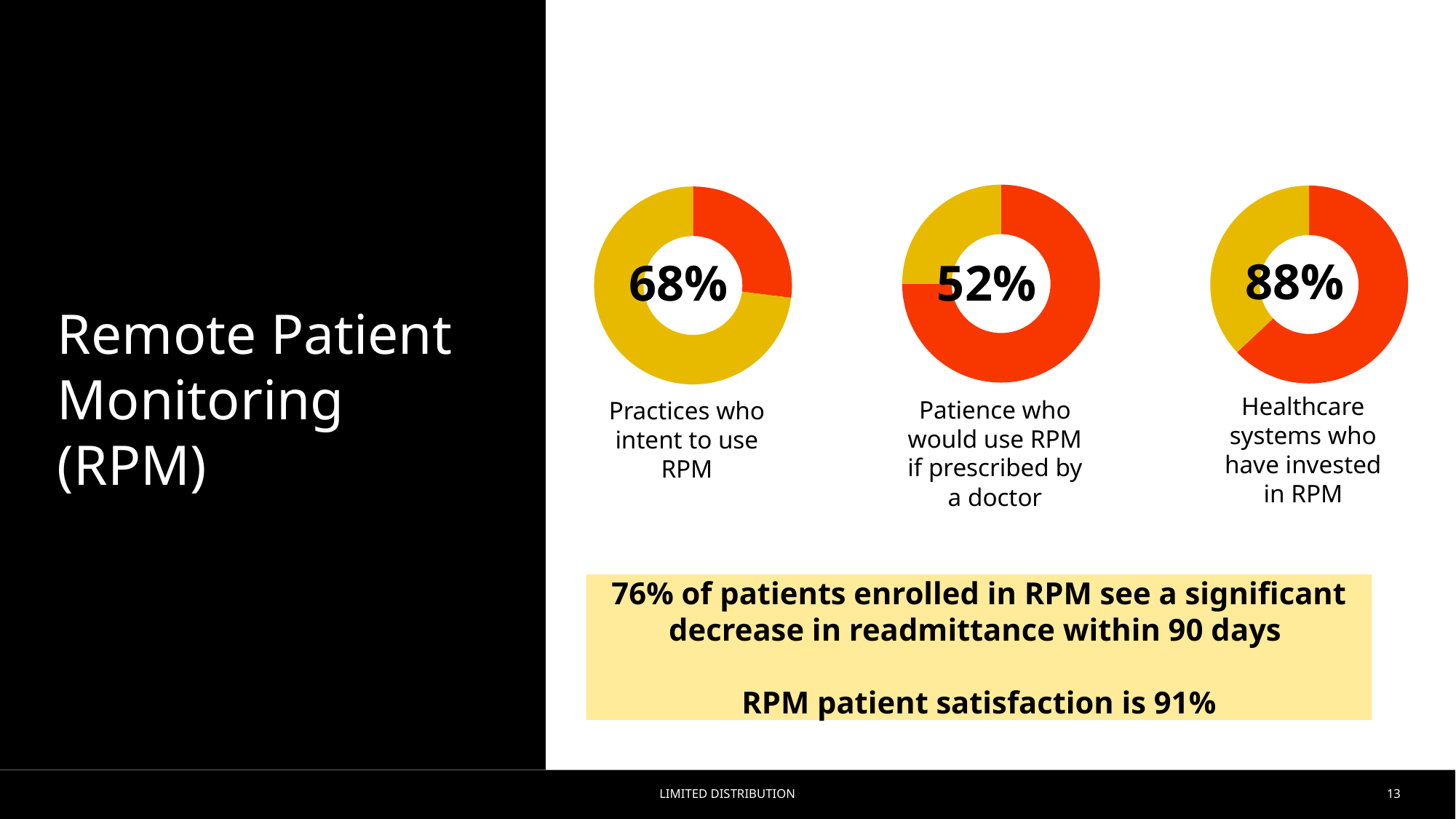
Which of the three donut charts shows the lowest percentage? Patience who would use RPM if prescribed by a doctor What percentage is shown in the donut chart labelled 'Healthcare systems who have invested in RPM'? 88% What two colours are used for the slices in the donut charts? Yellow and red What percentage is shown in the donut chart labelled 'Patience who would use RPM if prescribed by a doctor'? 52% What percentage is shown in the donut chart labelled 'Practices who intent to use RPM'? 68% What kind of chart is used to display the three percentages on the slide? Donut (pie) chart What is the difference between the percentage for practices who intent to use RPM and the percentage for patients who would use RPM if prescribed by a doctor? 16% How many donut charts are shown on the slide? 3 Which of the three donut charts shows the highest percentage? Healthcare systems who have invested in RPM Is the value for healthcare systems who have invested in RPM greater or less than 80%? greater Which is larger: the percentage for practices who intent to use RPM or the percentage for patients who would use RPM if prescribed by a doctor? Practices who intent to use RPM What is the difference between the percentage for healthcare systems who have invested in RPM and the percentage for practices who intent to use RPM? 20%